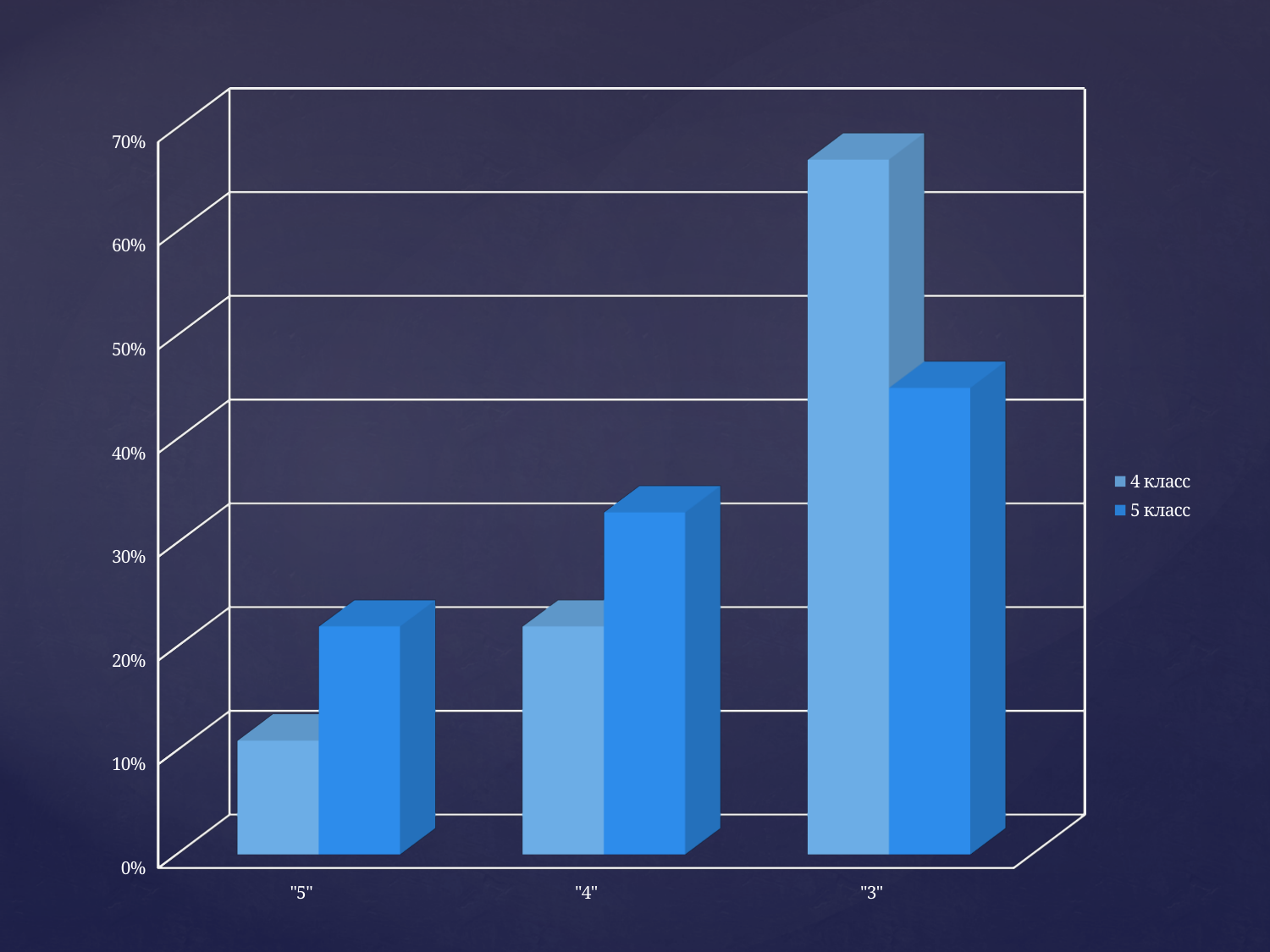
Which category has the highest value for the 5 класс series? "3" Do the values for the 4 класс series rise or fall from left to right along the x axis? rise Is the value for 4 класс in category "3" greater or less than 50%? greater How many series does the legend list? 2 Which category has the highest value for the 4 класс series? "3" Is the value for 5 класс in category "4" greater or less than 20%? greater For category "5", which series has the larger value, 4 класс or 5 класс? 5 класс How many categories are shown on the x axis? 3 Is the value for 4 класс in category "5" greater or less than 20%? less For category "3", which series has the larger value, 4 класс or 5 класс? 4 класс What kind of chart is shown on the slide? bar chart Which category has the lowest value for the 4 класс series? "5"